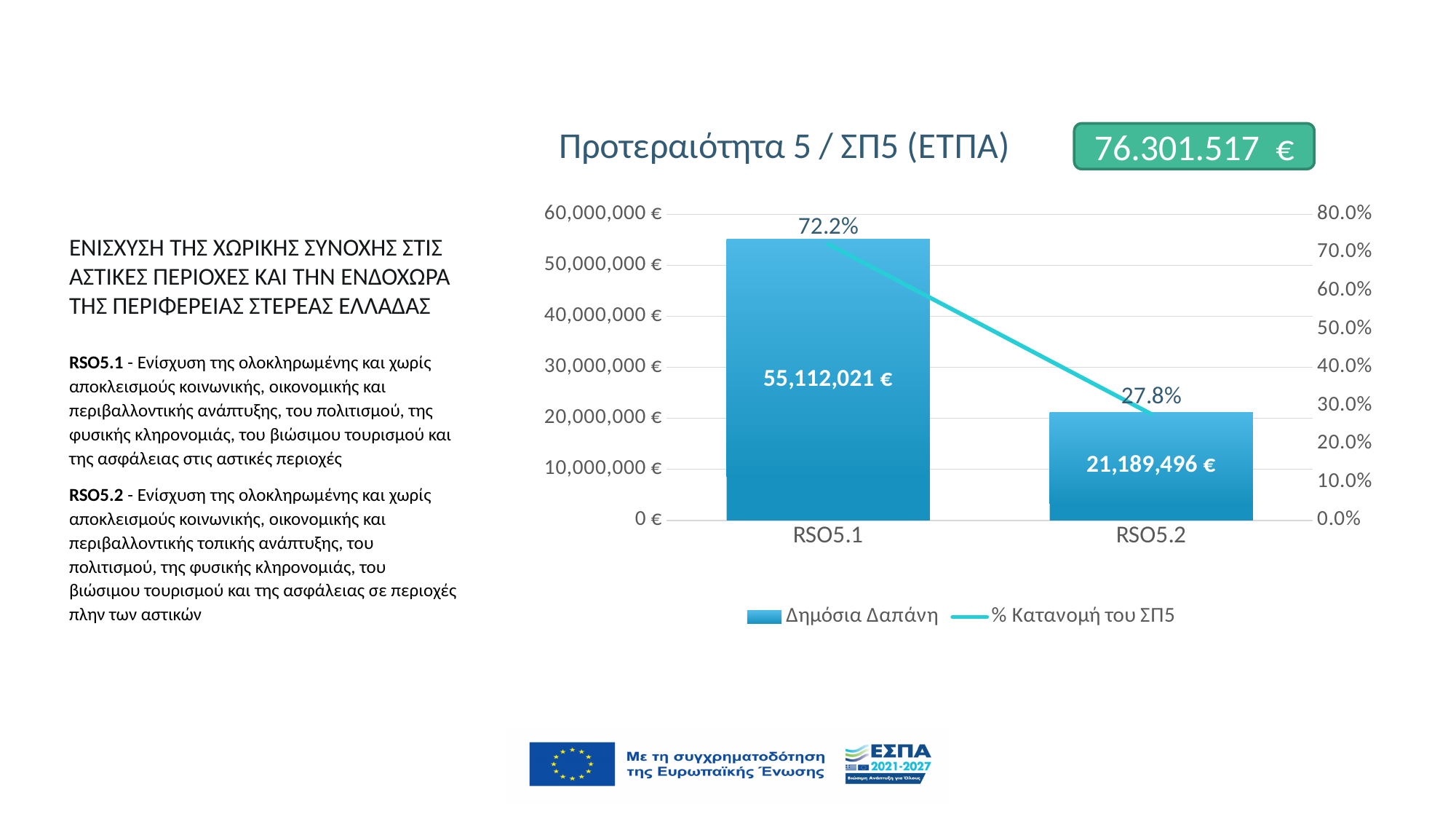
What is the Δημόσια Δαπάνη value for RSO5.2? 21,189,496 € What is the % Κατανομή του ΣΠ5 value for RSO5.2? 27.8% Is the Δημόσια Δαπάνη for RSO5.2 greater or less than 20,000,000 €? greater Which category has the lowest % Κατανομή του ΣΠ5? RSO5.2 What is the title of the chart? Προτεραιότητα 5 / ΣΠ5 (ΕΤΠΑ) Which series is drawn as a line in the chart? % Κατανομή του ΣΠ5 How many series does the chart legend list? 2 What is the difference in Δημόσια Δαπάνη between RSO5.1 and RSO5.2? 33,922,525 € How many categories are shown on the x axis of the chart? 2 What is the Δημόσια Δαπάνη value for RSO5.1? 55,112,021 € Which category has the highest Δημόσια Δαπάνη? RSO5.1 What is the % Κατανομή του ΣΠ5 value for RSO5.1? 72.2%